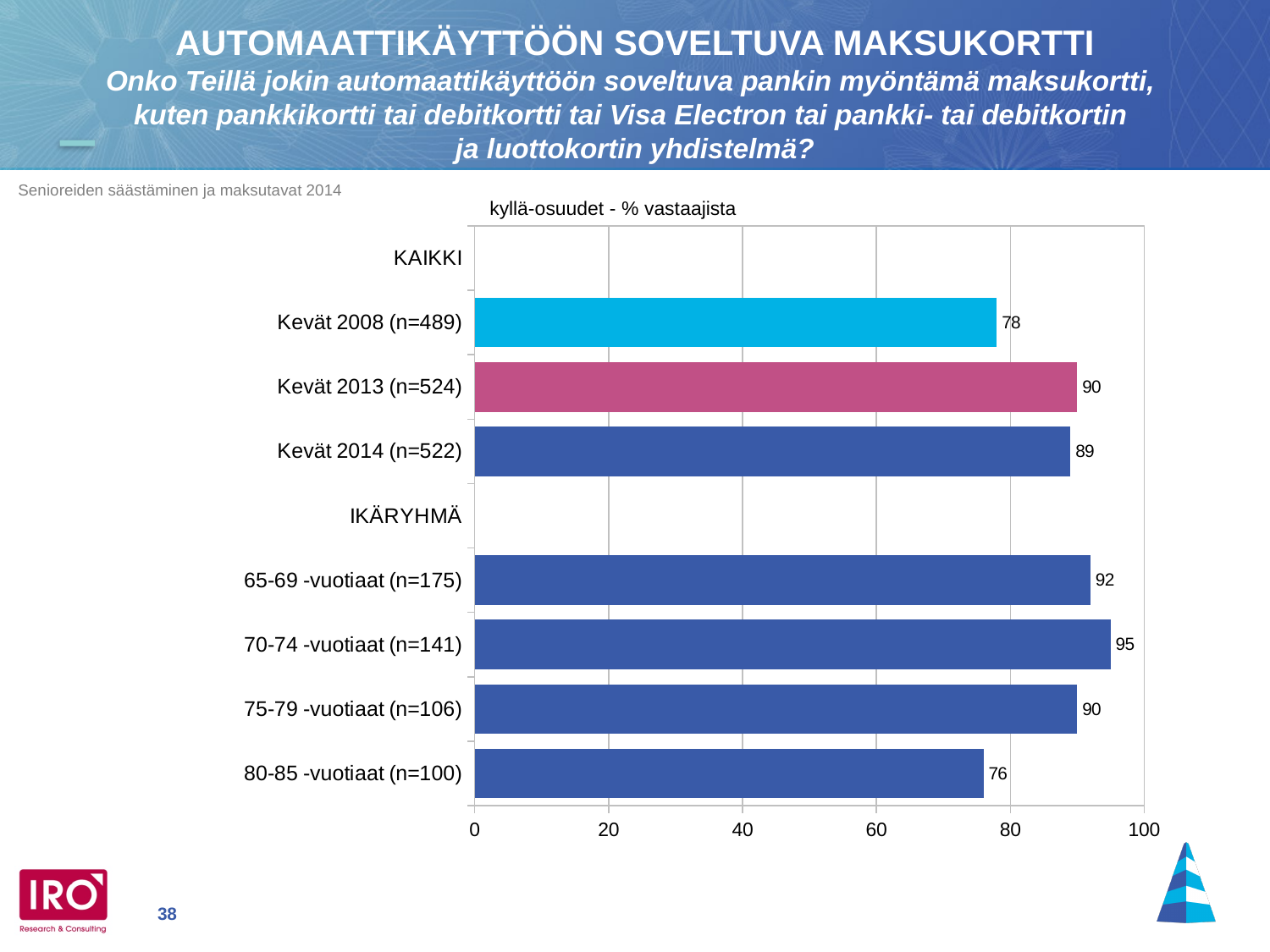
Which category has the lowest value? 80-85 -vuotiaat (n=100) What is the value for 70-74 -vuotiaat (n=141)? 95 Which is larger, the value for 65-69 -vuotiaat (n=175) or the value for 75-79 -vuotiaat (n=106)? 65-69 -vuotiaat (n=175) What kind of chart is shown on the slide? bar chart Which category has the highest value? 70-74 -vuotiaat (n=141) What is the difference between the values for Kevät 2013 (n=524) and Kevät 2008 (n=489)? 12 What is the title of the chart? kyllä-osuudet - % vastaajista How many bars are plotted in the chart? 7 Is the value for Kevät 2014 (n=522) greater or less than 80? greater What is the value for 80-85 -vuotiaat (n=100)? 76 What is the value for Kevät 2008 (n=489)? 78 What is the difference between the values for 70-74 -vuotiaat (n=141) and 80-85 -vuotiaat (n=100)? 19